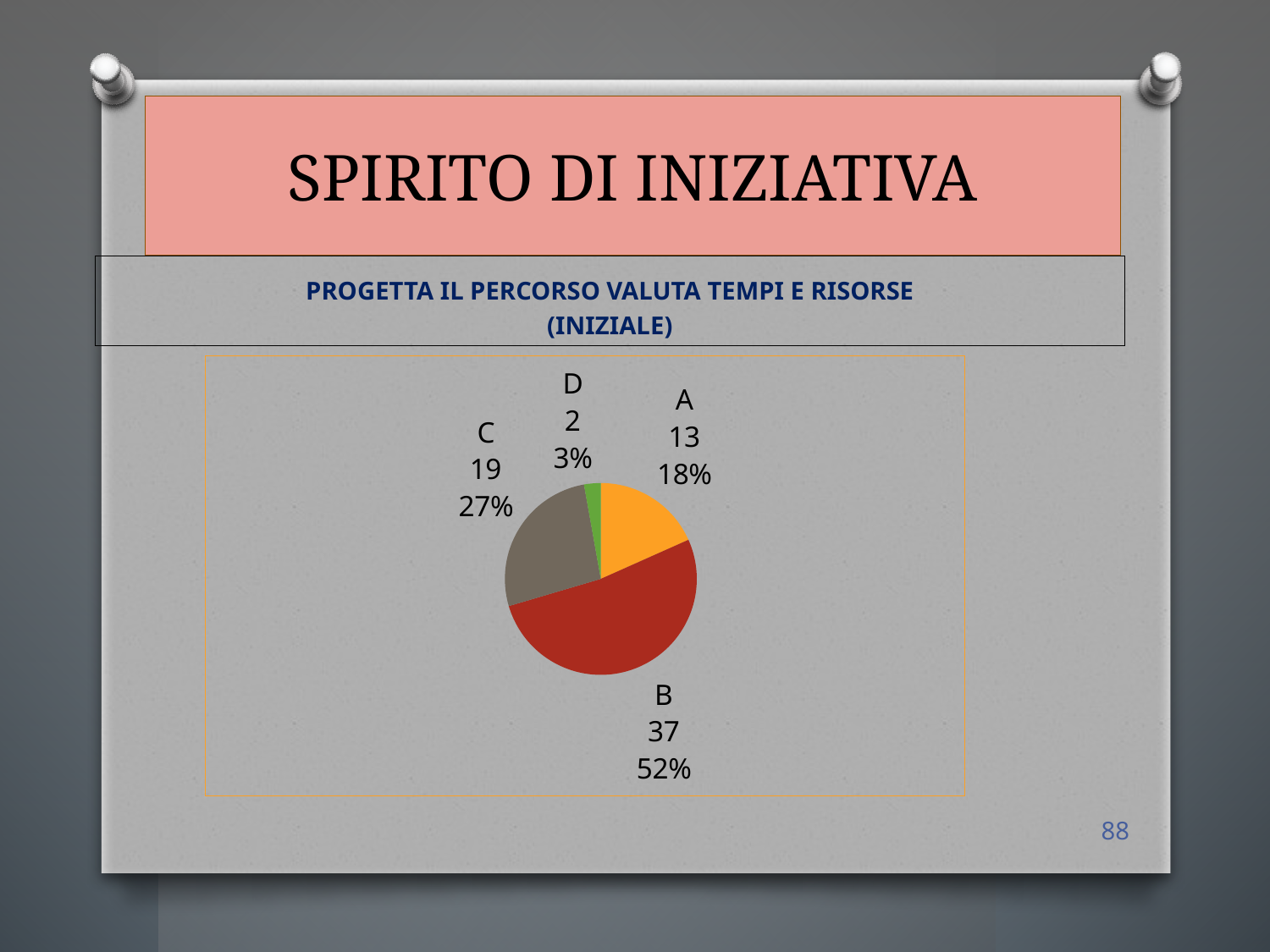
What is the value for category C? 19 What is the value for category A? 13 How many slices does the pie chart have? 4 What share of the pie does category A represent? 18% Which category has the largest slice? B What share of the pie does category C represent? 27% What kind of chart is shown on the slide? pie chart Which category has the smallest slice? D What is the difference between the values for B and C? 18 What is the value for category B? 37 Which is larger, the value for A or the value for C? C What is the value for category D? 2